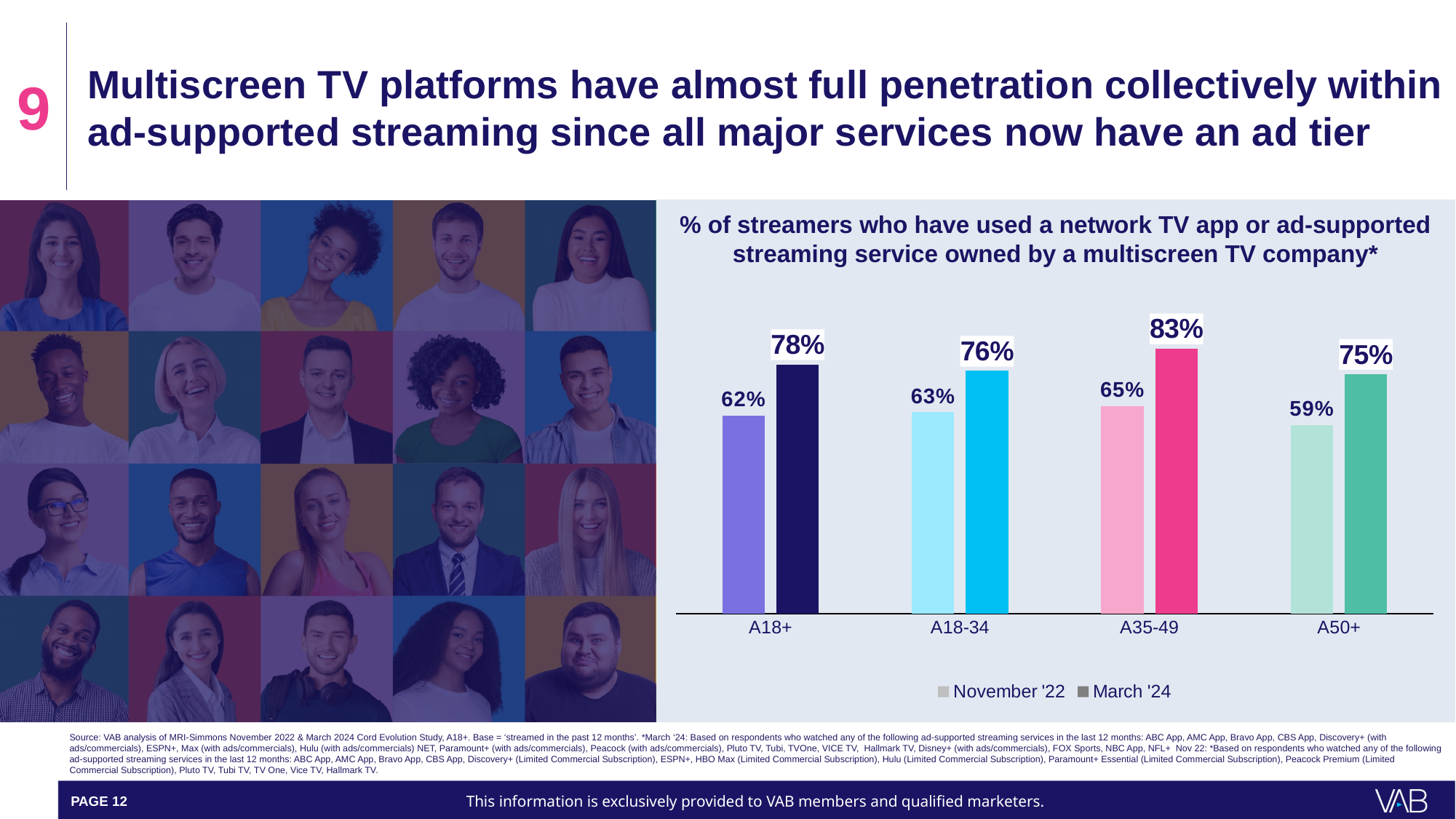
How many age groups are shown on the x axis? 4 Which age group has the highest March '24 value? A35-49 What are the two series named in the legend? November '22 and March '24 What is the difference between the March '24 and November '22 values for A18-34? 13 percentage points What is the difference between the March '24 and November '22 values for A35-49? 18 percentage points What kind of chart is shown on the slide? Bar chart What is the March '24 value for A18+? 78% What is the November '22 value for A50+? 59% How many series does the legend list? 2 What is the March '24 value for A35-49? 83% Which age group has the lowest November '22 value? A50+ Which is larger: the November '22 value for A35-49 or the November '22 value for A18+? A35-49